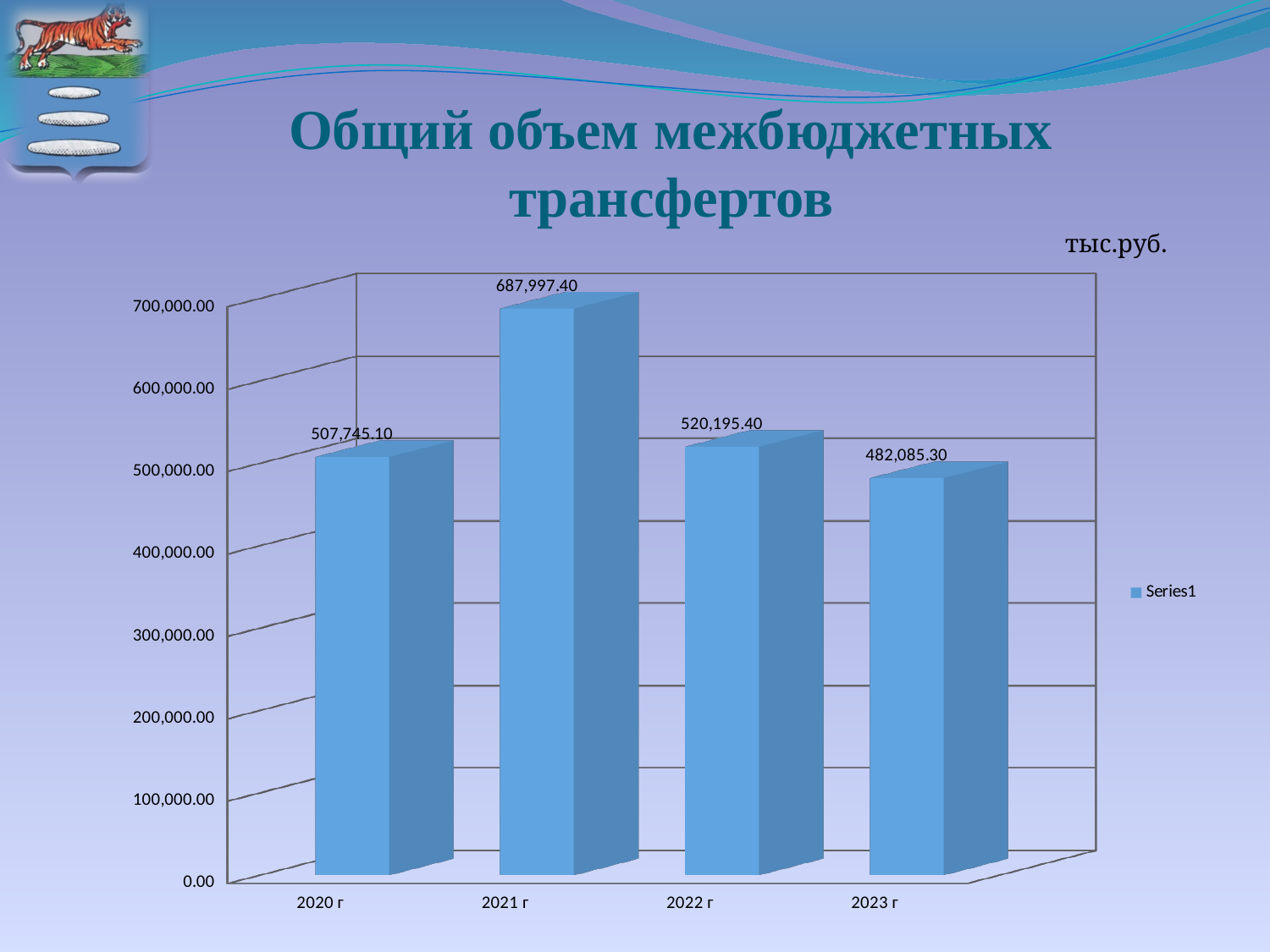
Which is larger, the value for 2022 г or the value for 2020 г? 2022 г What is the value for 2020 г? 507,745.10 What is the difference between the values for 2022 г and 2023 г? 38,110.10 What kind of chart is shown on the slide? Bar chart What is the value for 2023 г? 482,085.30 Which year has the lowest value? 2023 г Which year has the highest value? 2021 г What is the value for 2022 г? 520,195.40 How many years are shown on the chart? 4 What is the value for 2021 г? 687,997.40 What is the difference between the values for 2021 г and 2020 г? 180,252.30 What is the title of the chart? Общий объем межбюджетных трансфертов